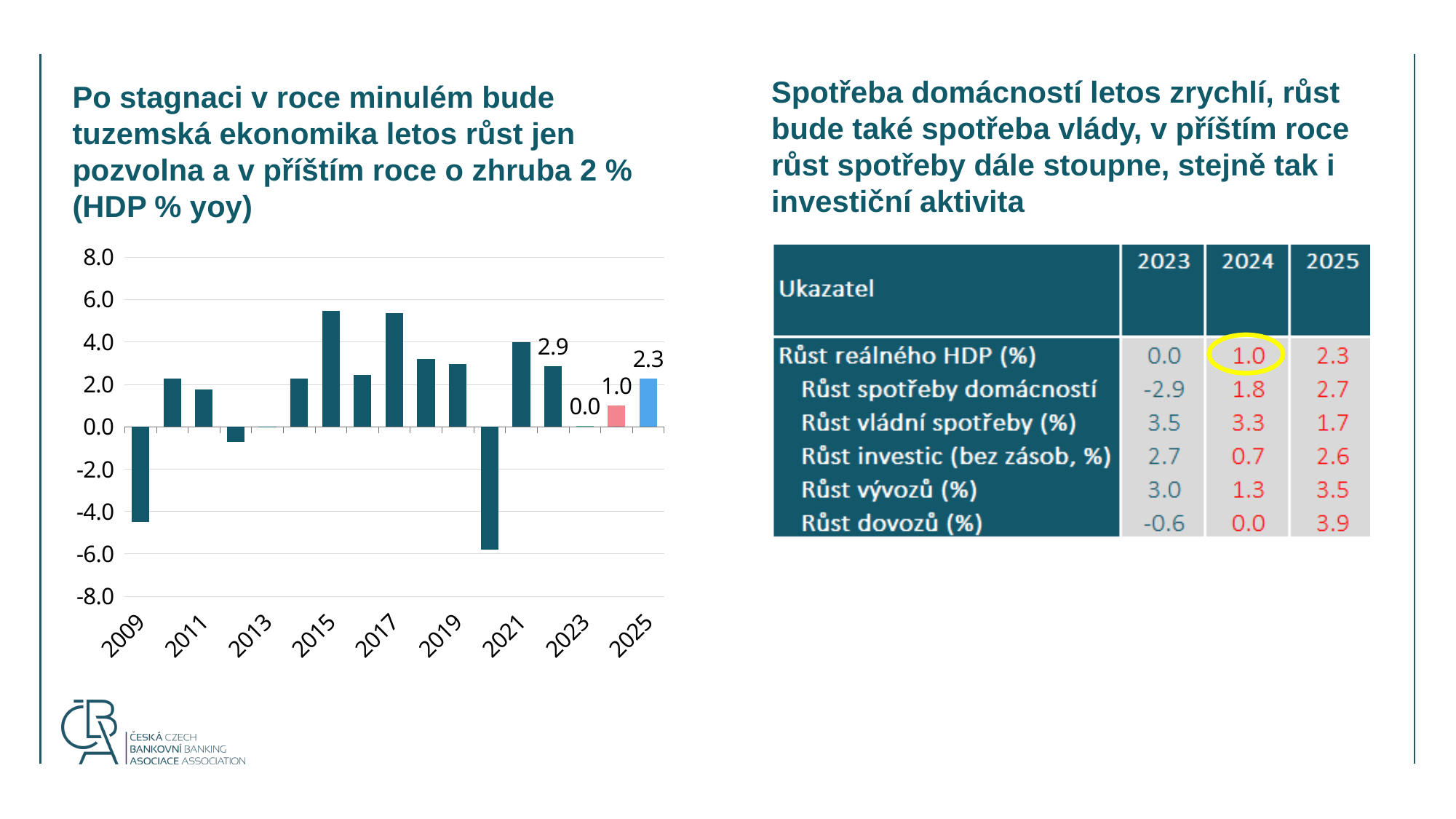
What is the value shown for 2024 in the bar chart? 1.0 What is the difference between the values for 2025 and 2024 in the bar chart? 1.3 Is the value for 2021 in the bar chart greater or less than 2.0? greater How many years are plotted in the bar chart? 17 What is the value shown for 2022 in the bar chart? 2.9 Which year has the lowest value in the bar chart? 2020 Do the values in the bar chart rise or fall from 2023 to 2025? rise What kind of chart is shown on the left of the slide? bar chart Which is larger in the bar chart, the value for 2024 or the value for 2025? 2025 Is the value for 2009 in the bar chart greater or less than -4.0? less What is the value shown for 2025 in the bar chart? 2.3 What is the value shown for 2023 in the bar chart? 0.0